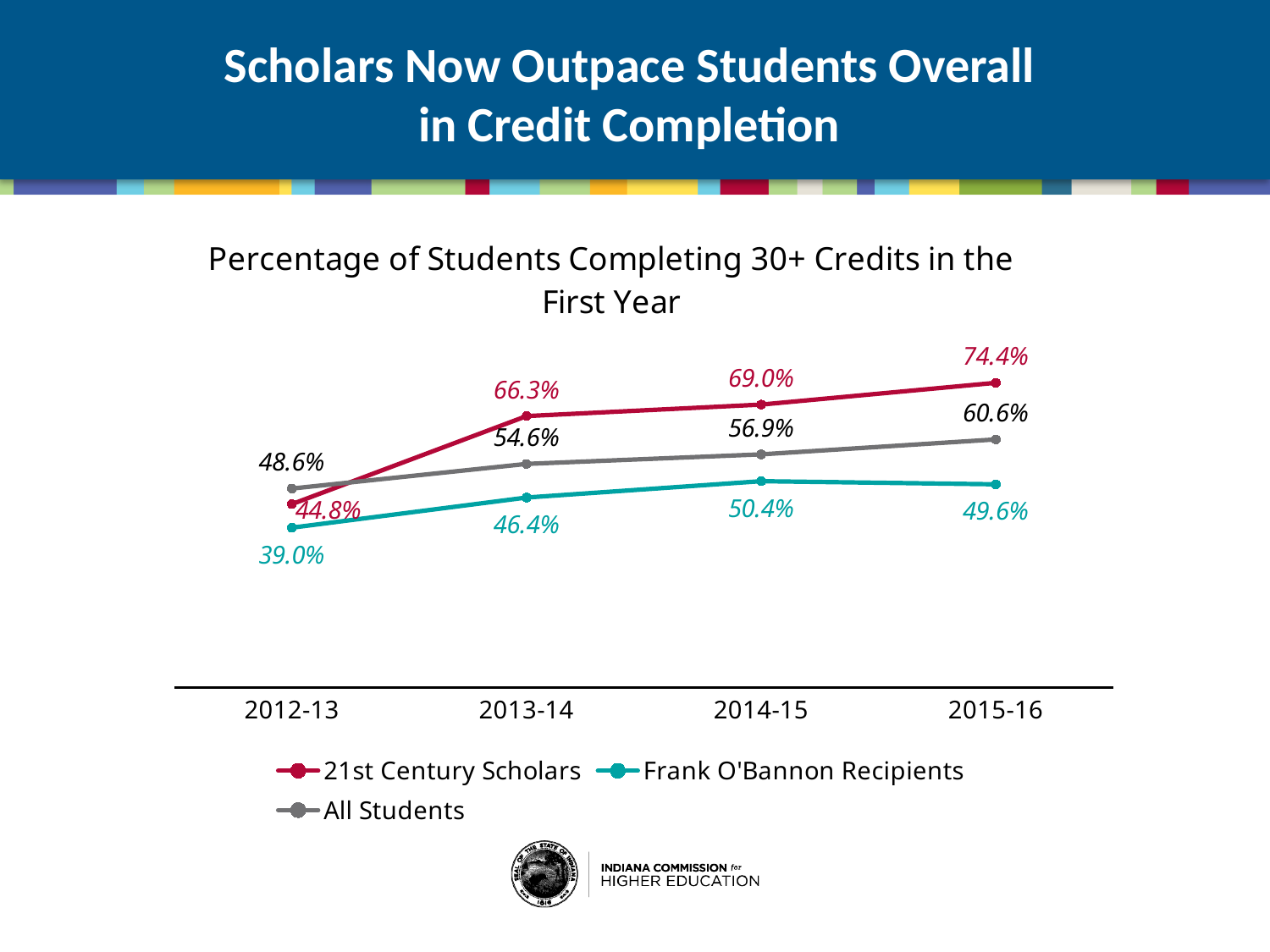
What was the value for Frank O'Bannon Recipients in 2012-13? 39.0% In 2012-13, which group had the higher percentage: 21st Century Scholars or All Students? All Students What percentage of 21st Century Scholars completed 30+ credits in the first year in 2015-16? 74.4% Does the All Students line rise or fall from 2012-13 to 2015-16? Rise What was the value for All Students in 2014-15? 56.9% What kind of chart is shown on the slide? Line chart In which year did Frank O'Bannon Recipients have their lowest percentage? 2012-13 How many series does the legend list? 3 What was the value for 21st Century Scholars in 2013-14? 66.3% How many academic years are shown on the x axis? 4 In which year did 21st Century Scholars have their highest percentage? 2015-16 What is the difference between 21st Century Scholars and All Students in 2015-16? 13.8 percentage points